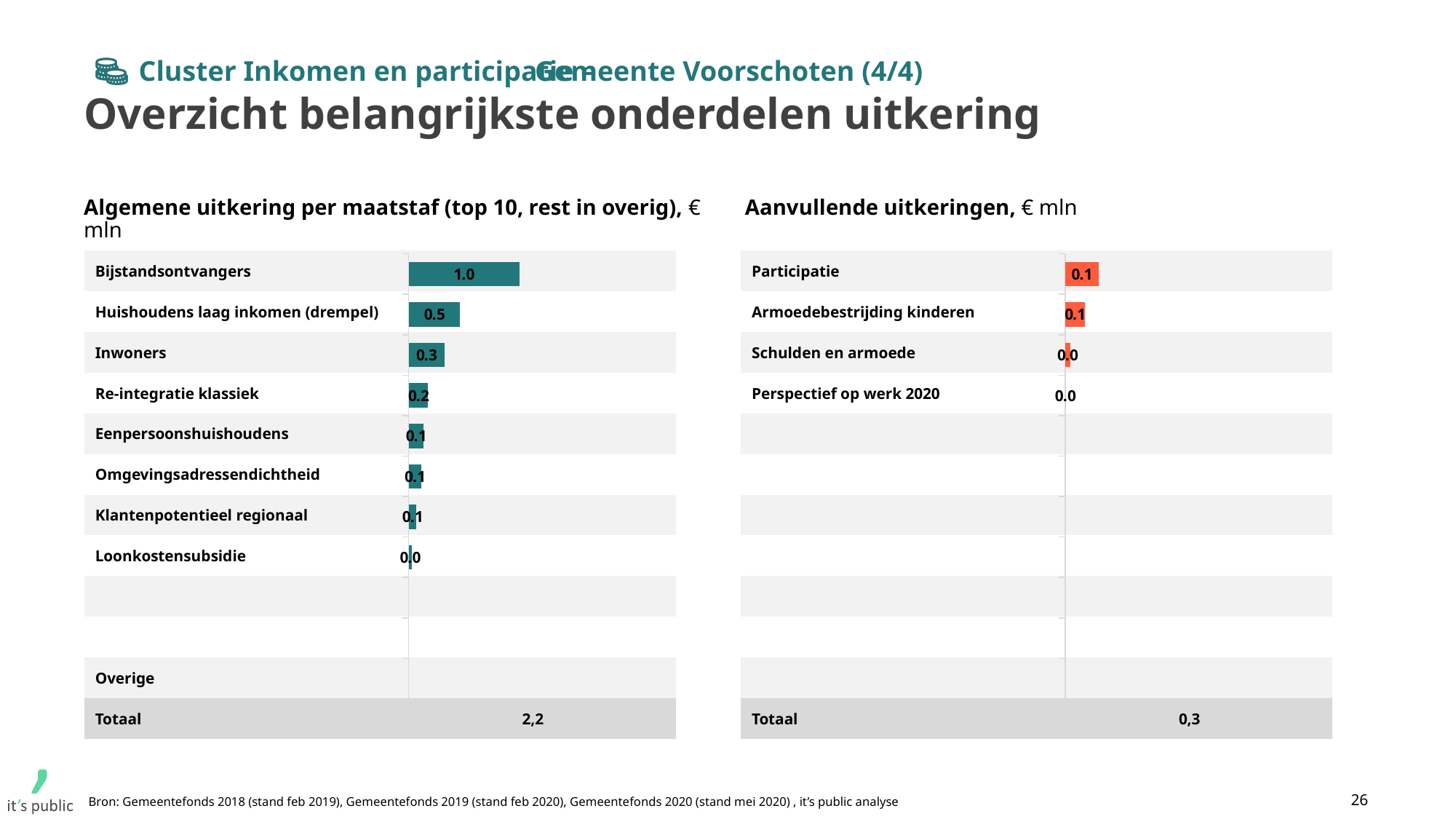
In the chart 'Algemene uitkering per maatstaf', what is the value for Bijstandsontvangers? 1.0 In the chart 'Algemene uitkering per maatstaf', which category has the highest value? Bijstandsontvangers In the chart 'Algemene uitkering per maatstaf', what is the difference between Bijstandsontvangers and Huishoudens laag inkomen (drempel)? 0.5 In the chart 'Algemene uitkering per maatstaf', which category has the lowest value? Loonkostensubsidie In the chart 'Algemene uitkering per maatstaf', what is the value for Inwoners? 0.3 In the chart 'Algemene uitkering per maatstaf', which is larger: Inwoners or Re-integratie klassiek? Inwoners In the chart 'Algemene uitkering per maatstaf', what is the value for Huishoudens laag inkomen (drempel)? 0.5 In the chart 'Aanvullende uitkeringen', what is the value for Perspectief op werk 2020? 0.0 In the chart 'Aanvullende uitkeringen', what is the value for Participatie? 0.1 What kind of chart is 'Aanvullende uitkeringen'? Bar chart In the chart 'Algemene uitkering per maatstaf', what is the Totaal value shown? 2,2 In the chart 'Aanvullende uitkeringen', how many categories are plotted? 4